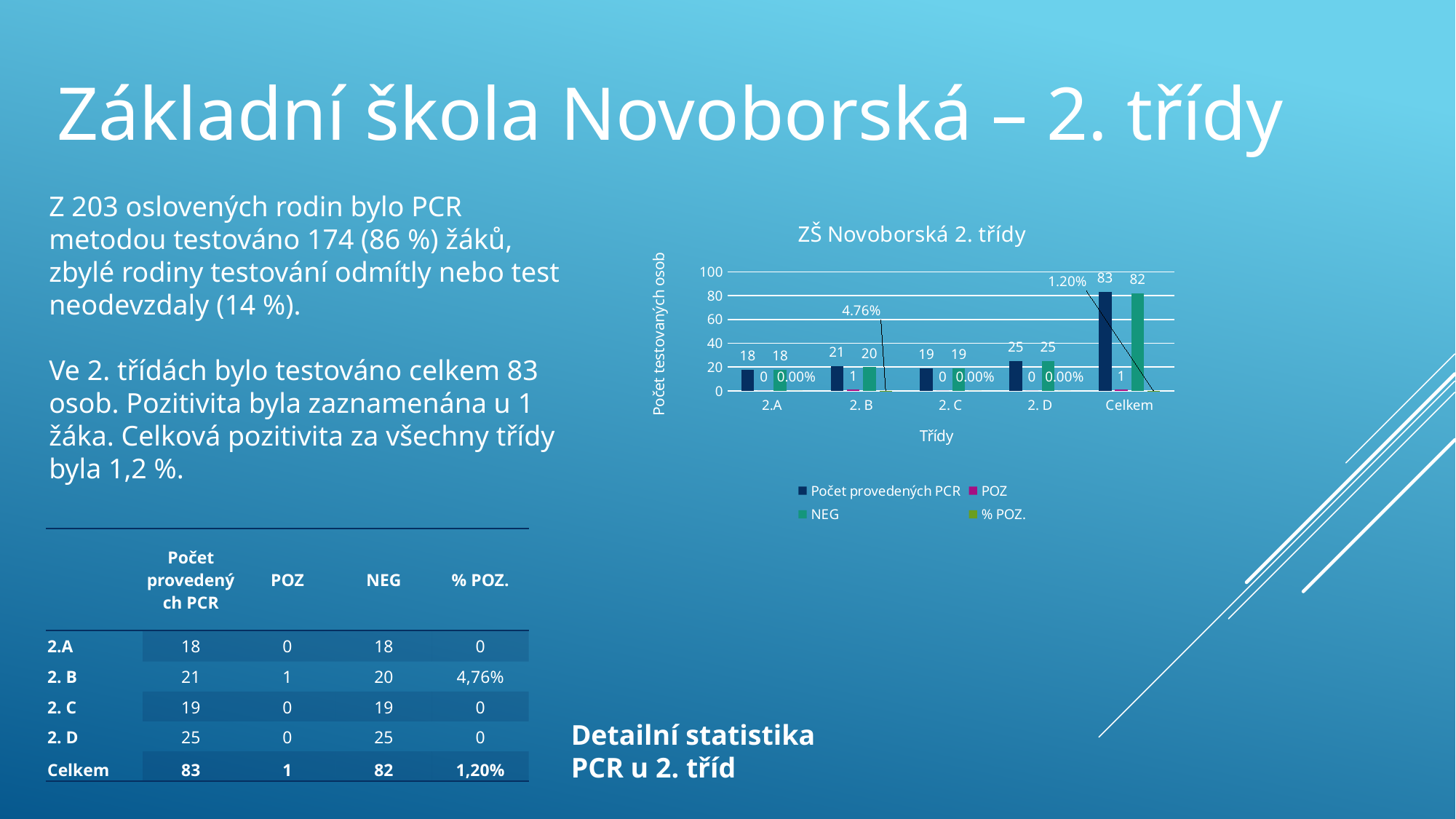
What is the NEG value for 2. D? 25 What is the chart's title? ZŠ Novoborská 2. třídy How many series does the chart legend list? 4 Which is larger, the NEG value for 2. B or the NEG value for 2. C? 2. B What is the difference between the Počet provedených PCR values for 2. D and 2. C? 6 What is the POZ value for Celkem? 1 Which category has the highest Počet provedených PCR value? Celkem Among the classes 2.A, 2. B, 2. C and 2. D, which has the lowest NEG value? 2.A How many categories are shown on the x axis of the chart? 5 What is the % POZ. value for 2. B? 4.76% What type of chart is shown on the slide? bar chart What is the value of Počet provedených PCR for 2. B? 21